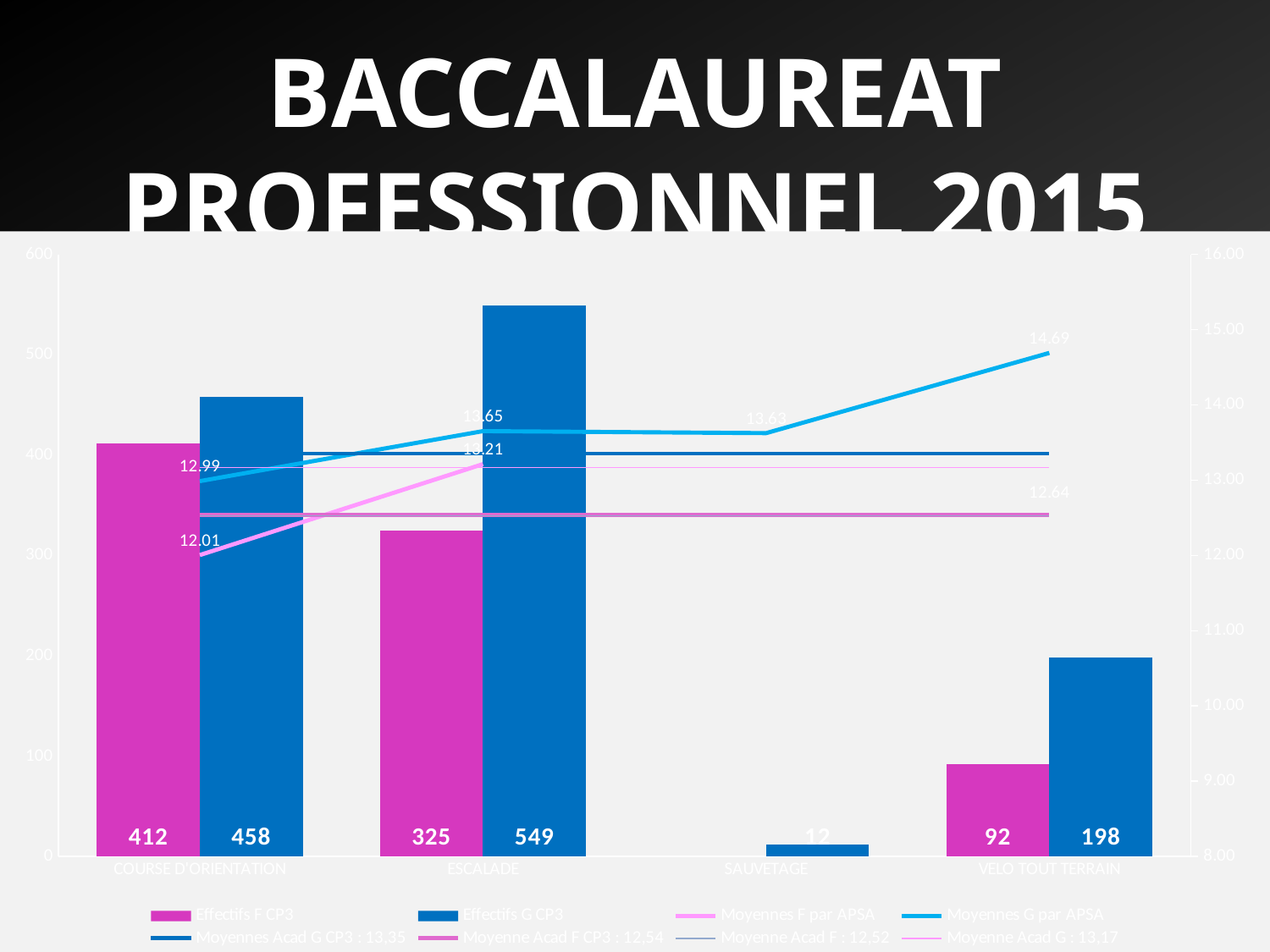
How many categories are shown on the x axis? 4 What is the difference between Effectifs G CP3 and Effectifs F CP3 for ESCALADE? 224 What is the Moyennes G par APSA value for VELO TOUT TERRAIN? 14.69 Which category has the lowest Effectifs F CP3 value among those with a labelled bar? VELO TOUT TERRAIN What is the value of Effectifs G CP3 for SAUVETAGE? 12 Which is larger for COURSE D'ORIENTATION: Effectifs F CP3 or Effectifs G CP3? Effectifs G CP3 Which category has the highest Effectifs G CP3 value? ESCALADE What is the value of Effectifs G CP3 for ESCALADE? 549 Does the Moyennes G par APSA line rise or fall from SAUVETAGE to VELO TOUT TERRAIN? rise How many series does the legend list? 8 What is the title of the slide containing the chart? BACCALAUREAT PROFESSIONNEL 2015 What is the value of Effectifs F CP3 for COURSE D'ORIENTATION? 412